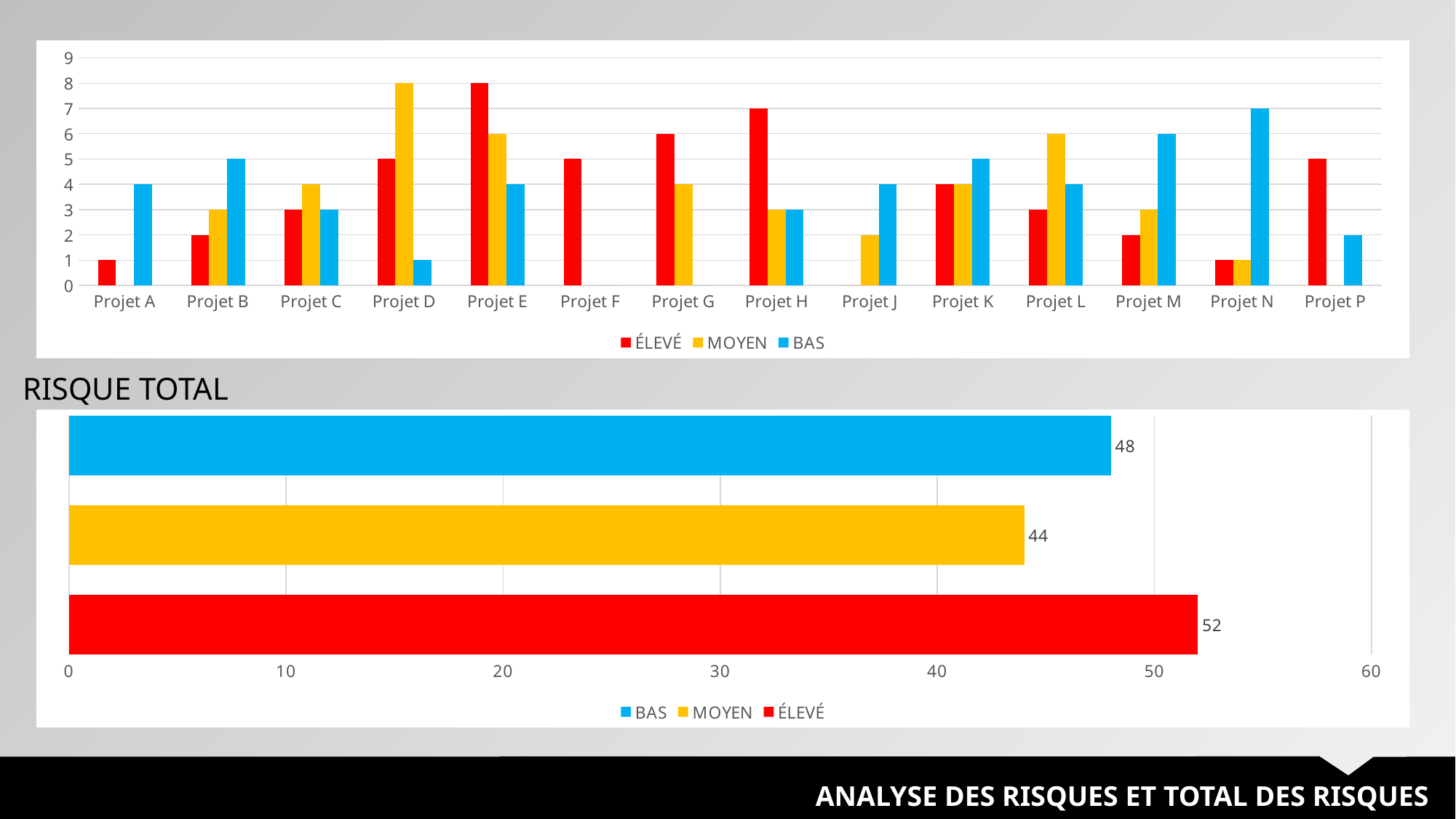
In the bottom chart titled RISQUE TOTAL, what is the value for MOYEN? 44 In the bottom chart titled RISQUE TOTAL, which category has the highest value? ÉLEVÉ In the top chart, how many projects are shown on the x axis? 14 In the bottom chart titled RISQUE TOTAL, what is the difference between the ÉLEVÉ value and the MOYEN value? 8 In the bottom chart titled RISQUE TOTAL, which category has the lowest value? MOYEN In the top chart, how many series does the legend list? 3 What kind of chart is the bottom chart titled RISQUE TOTAL? Bar chart In the bottom chart titled RISQUE TOTAL, is the value for BAS greater or less than 40? greater In the top chart, what is the ÉLEVÉ value for Projet E? 8 In the top chart, which series is shown in red according to the legend? ÉLEVÉ In the top chart, which is larger for Projet N: the BAS value or the ÉLEVÉ value? BAS In the bottom chart titled RISQUE TOTAL, what is the value for ÉLEVÉ? 52